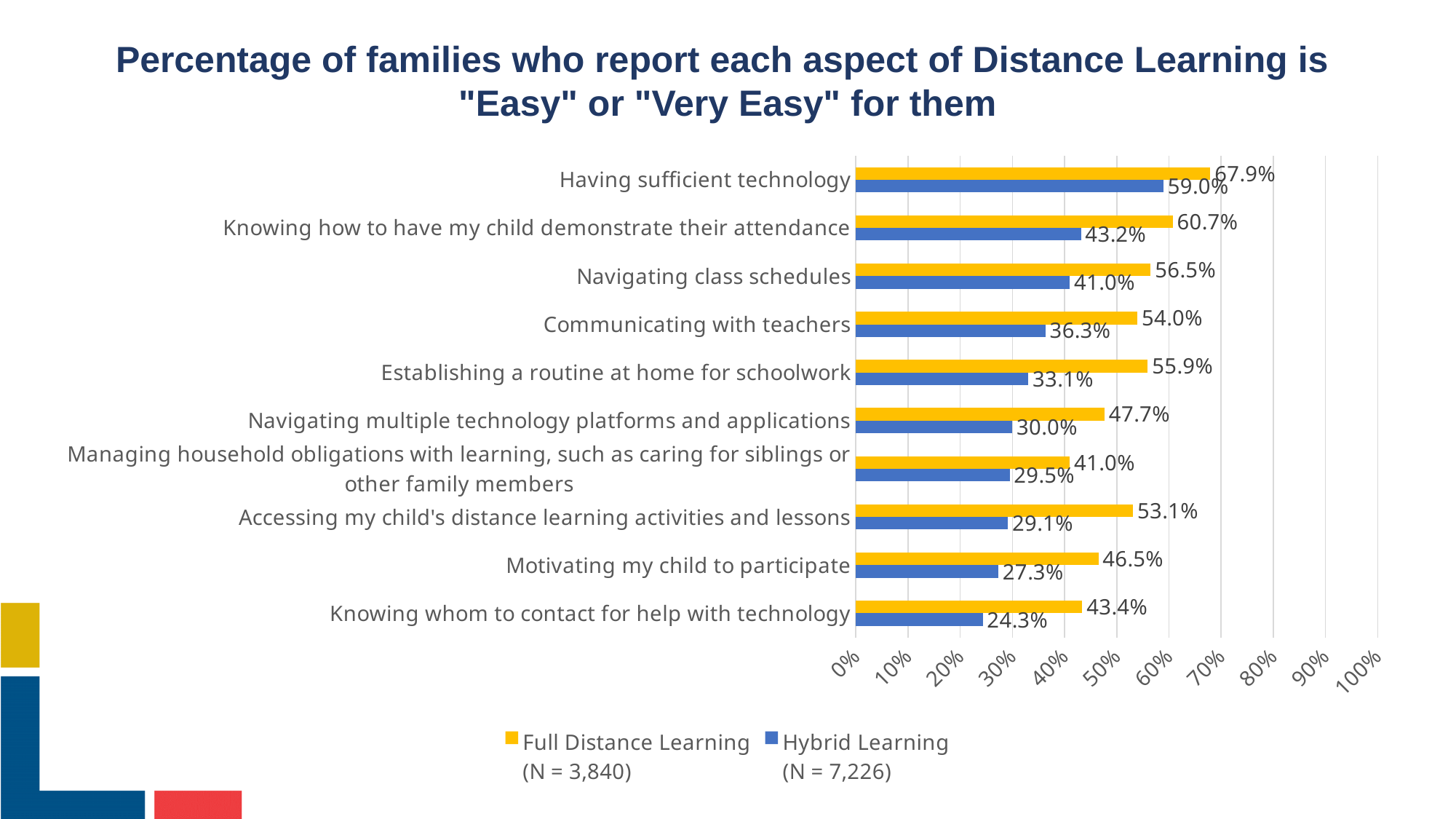
What is the Hybrid Learning value for "Knowing whom to contact for help with technology"? 24.3% What percentage of Full Distance Learning families report "Having sufficient technology" is easy or very easy? 67.9% What is the difference between the Full Distance Learning and Hybrid Learning values for "Establishing a routine at home for schoolwork"? 22.8% Which aspect has the lowest Hybrid Learning percentage? Knowing whom to contact for help with technology How many aspects of Distance Learning are listed on the chart? 10 How many series does the legend list? 2 What percentage of Hybrid Learning families report "Communicating with teachers" is easy or very easy? 36.3% For "Navigating class schedules", which series has the larger value: Full Distance Learning or Hybrid Learning? Full Distance Learning Which colour represents Full Distance Learning in the chart? Yellow What kind of chart is shown on the slide? Bar chart Which aspect has the highest Full Distance Learning percentage? Having sufficient technology What is the sample size (N) for the Hybrid Learning series shown in the legend? 7,226